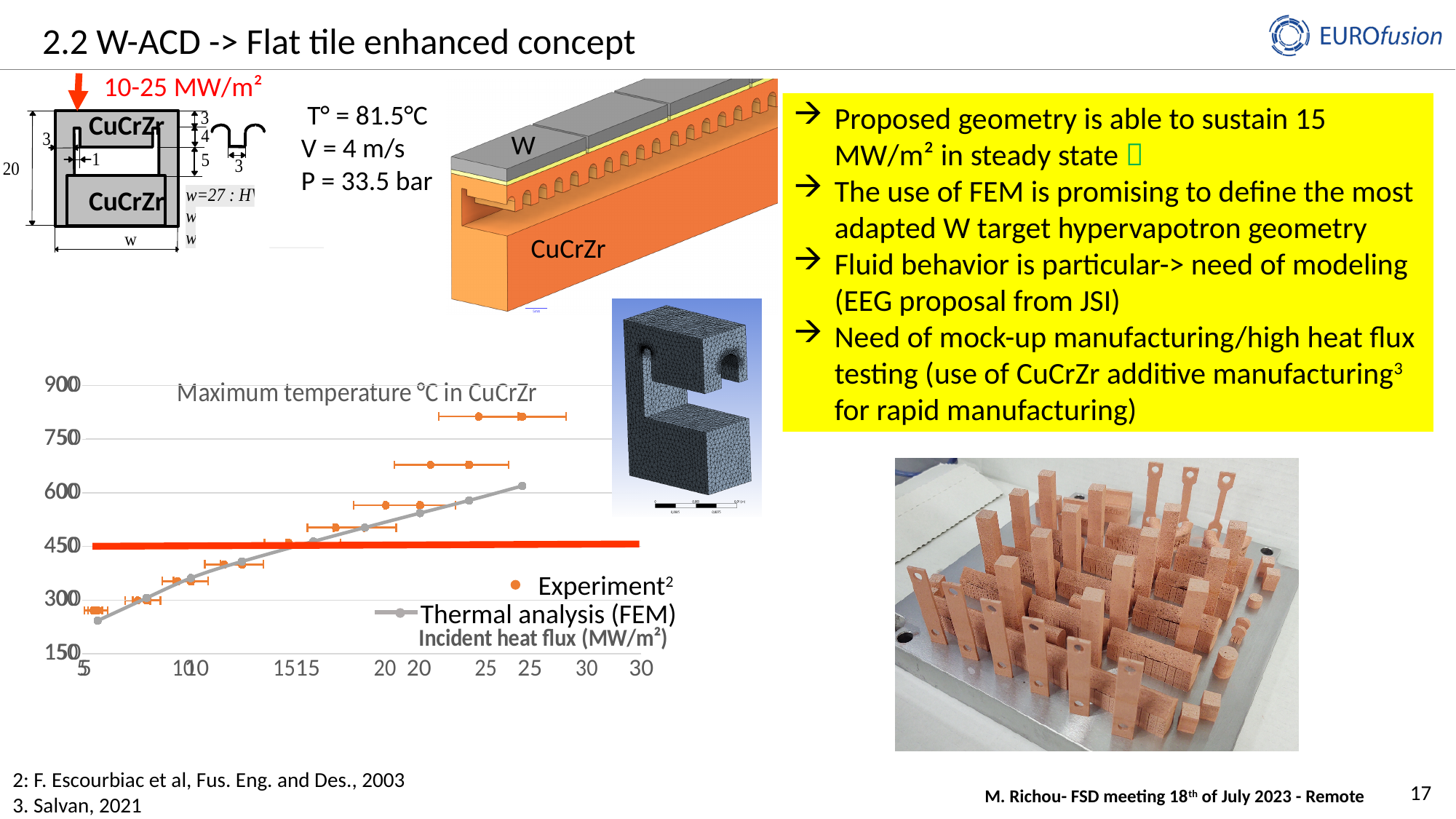
Is the highest Thermal analysis (FEM) value on the chart greater or less than 600? greater Is the highest Experiment value on the chart greater or less than 900? less Is the highest Experiment value on the chart greater or less than 750? greater How many series does the chart legend list? 2 What are the two series named in the chart legend? Experiment and Thermal analysis (FEM) Does the Experiment series rise or fall as the incident heat flux increases? rise What kind of chart is shown on the slide? line chart with markers (scatter) Does the Thermal analysis (FEM) series rise or fall as the incident heat flux increases? rise Which series reaches the higher maximum temperature on the chart, Experiment or Thermal analysis (FEM)? Experiment What is the title of the chart? Maximum temperature °C in CuCrZr